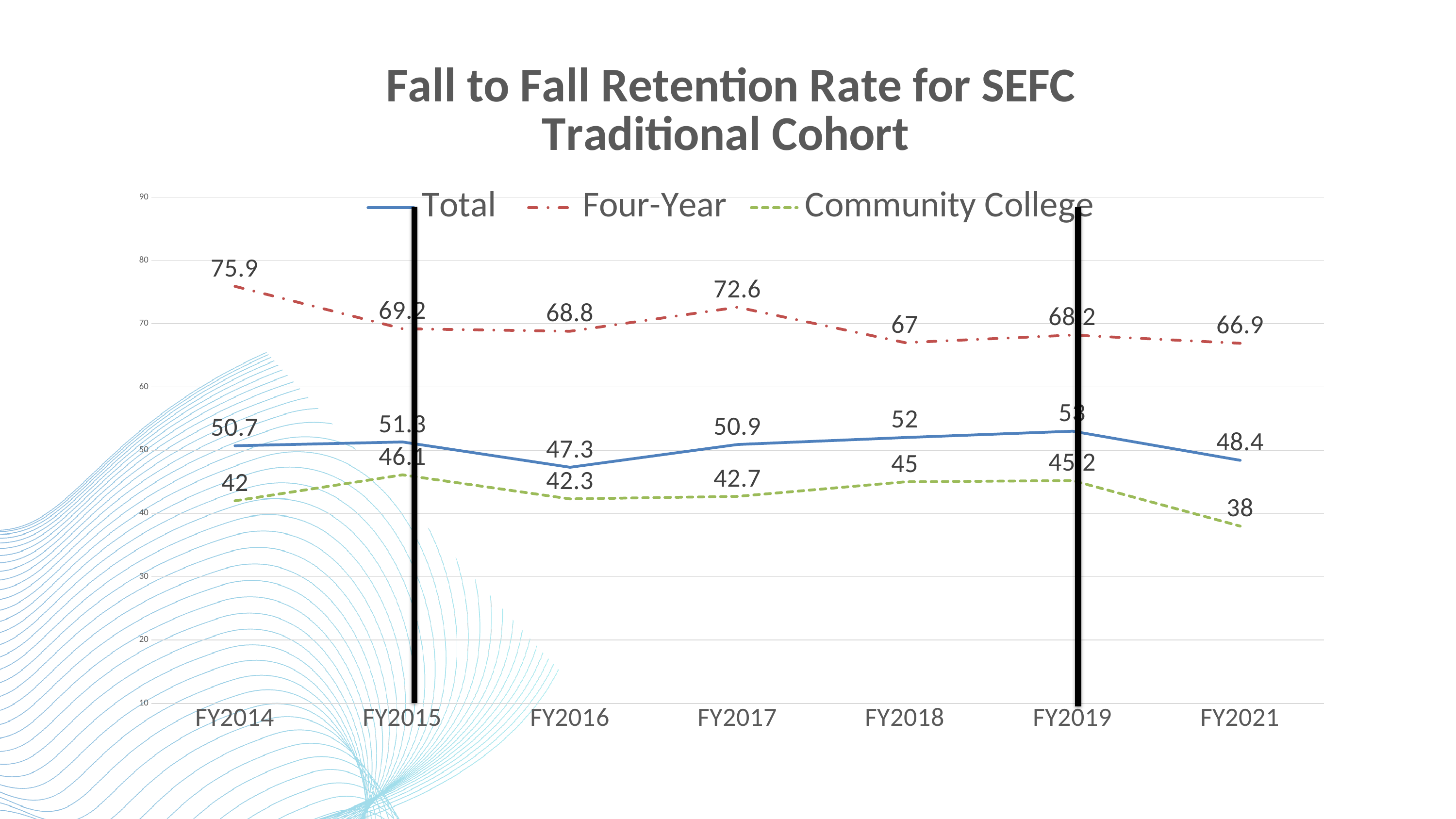
What is the Community College retention rate for FY2021? 38 What is the difference between the Four-Year and Community College retention rates in FY2016? 26.5 Is the Four-Year retention rate for FY2021 greater or less than 70? less What is the Four-Year retention rate for FY2014? 75.9 What type of chart is shown on the slide? line chart What is the Total retention rate for FY2018? 52 How many series does the legend list? 3 How many fiscal years are plotted on the x axis? 7 Which is larger in FY2018, the Total retention rate or the Community College retention rate? Total In which fiscal year is the Four-Year retention rate highest? FY2014 In which fiscal year is the Community College retention rate lowest? FY2021 What is the Four-Year retention rate for FY2017? 72.6